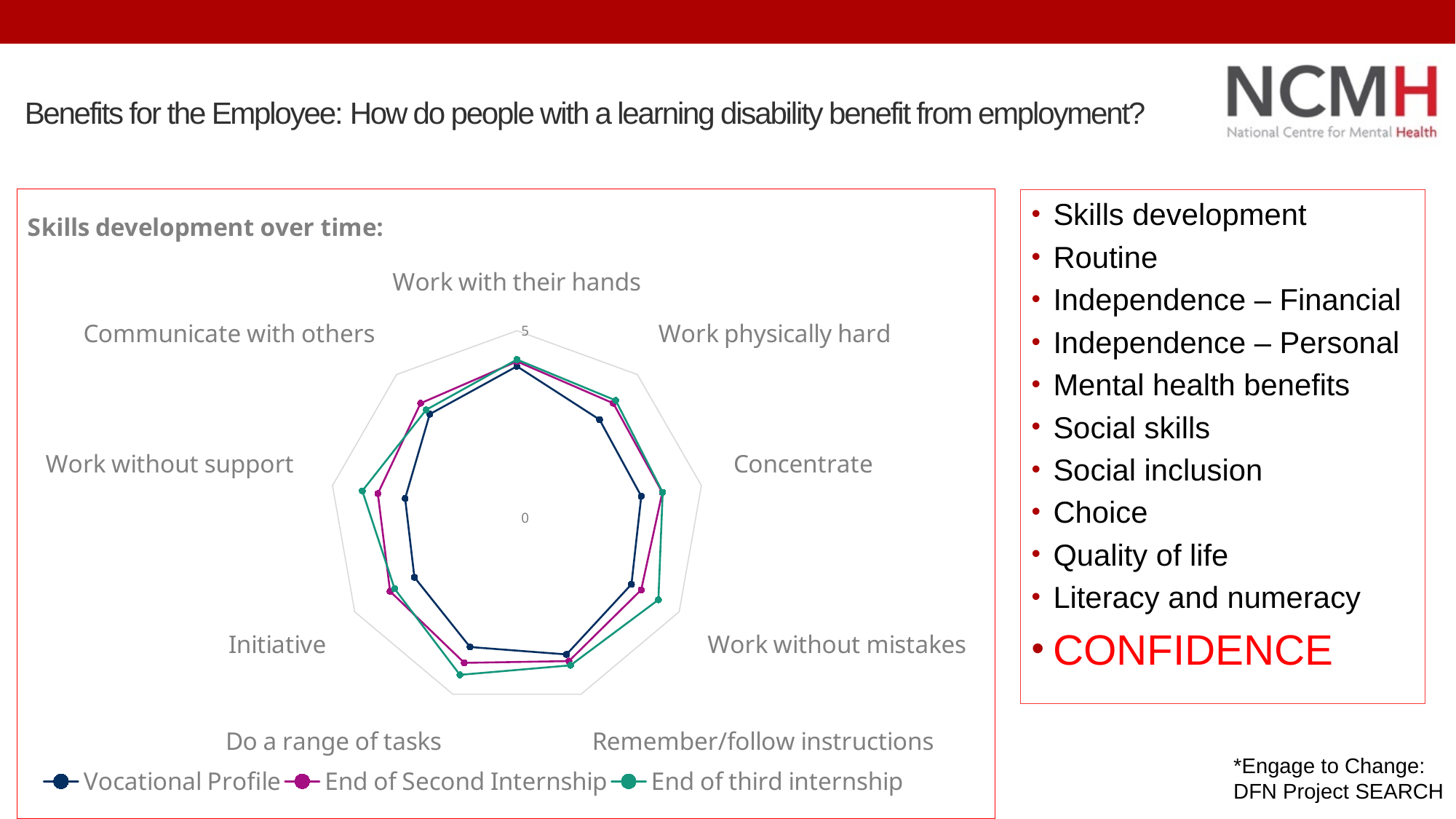
Which series are listed in the chart legend? Vocational Profile, End of Second Internship, End of third internship For 'Work physically hard', which series has the larger value: Vocational Profile or End of Second Internship? End of Second Internship How many skill categories are plotted on the radar chart? 9 How many series does the chart legend list? 3 What kind of chart is shown on the slide? Radar chart Which series forms the innermost line on the radar chart across most categories? Vocational Profile For 'Work without support', which series has the larger value: Vocational Profile or End of third internship? End of third internship What is the title of the chart on the slide? Skills development over time: Is the End of third internship value for 'Work without mistakes' greater or less than 5? less What is the maximum value shown on the radar chart's axis scale? 5